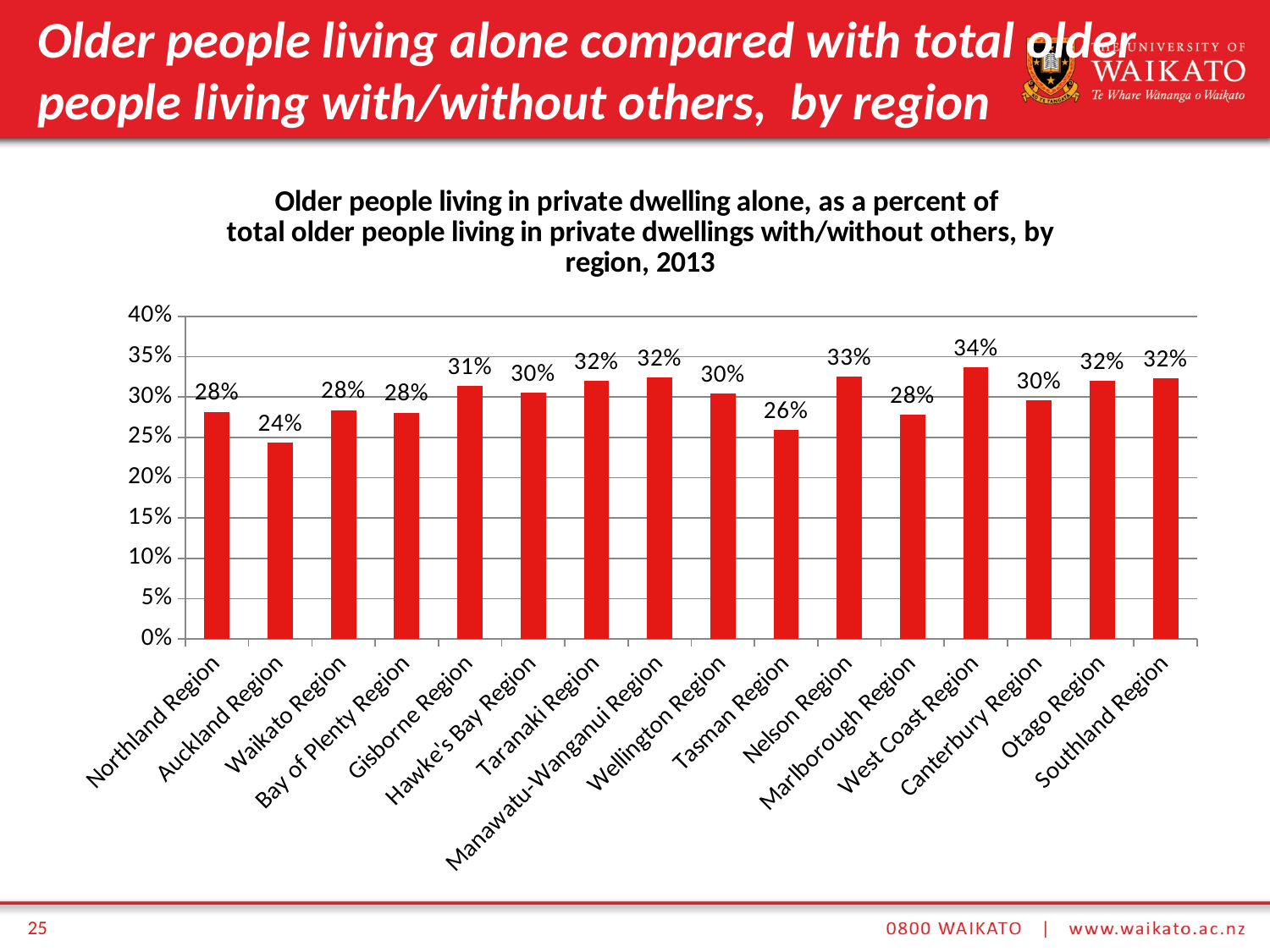
What is the difference between the values for West Coast Region and Auckland Region? 10 percentage points What is the value for West Coast Region? 34% How many regions are shown on the chart? 16 Which region has the lowest value? Auckland Region Is the value for Tasman Region greater or less than 30%? less What year does the chart title say the data is for? 2013 What is the value for Nelson Region? 33% Which region has the highest value? West Coast Region What is the value for Auckland Region? 24% Which is larger, the value for Nelson Region or Tasman Region? Nelson Region What kind of chart is shown on the slide? Bar chart What is the value for Tasman Region? 26%